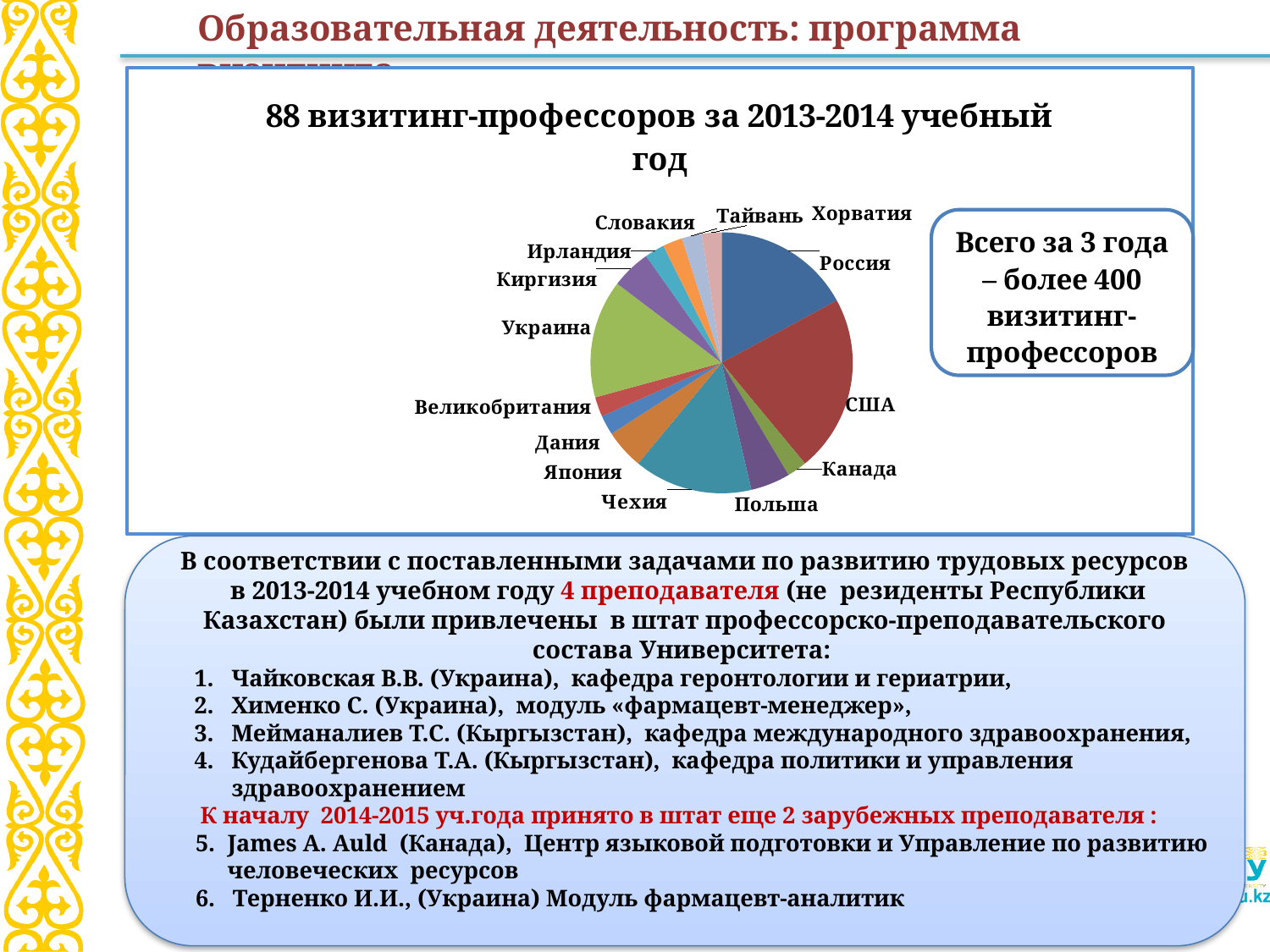
According to the chart title, how many visiting professors were there in the 2013-2014 academic year? 88 Which slice is larger, США or Канада? США How many countries (slices) are shown in the pie chart? 14 What is the title of the pie chart? 88 визитинг-профессоров за 2013-2014 учебный год Which slice is larger, Чехия or Великобритания? Чехия Which country has the largest slice in the pie chart? США What kind of chart is shown on the slide? pie chart Which slice is larger, Украина or Дания? Украина